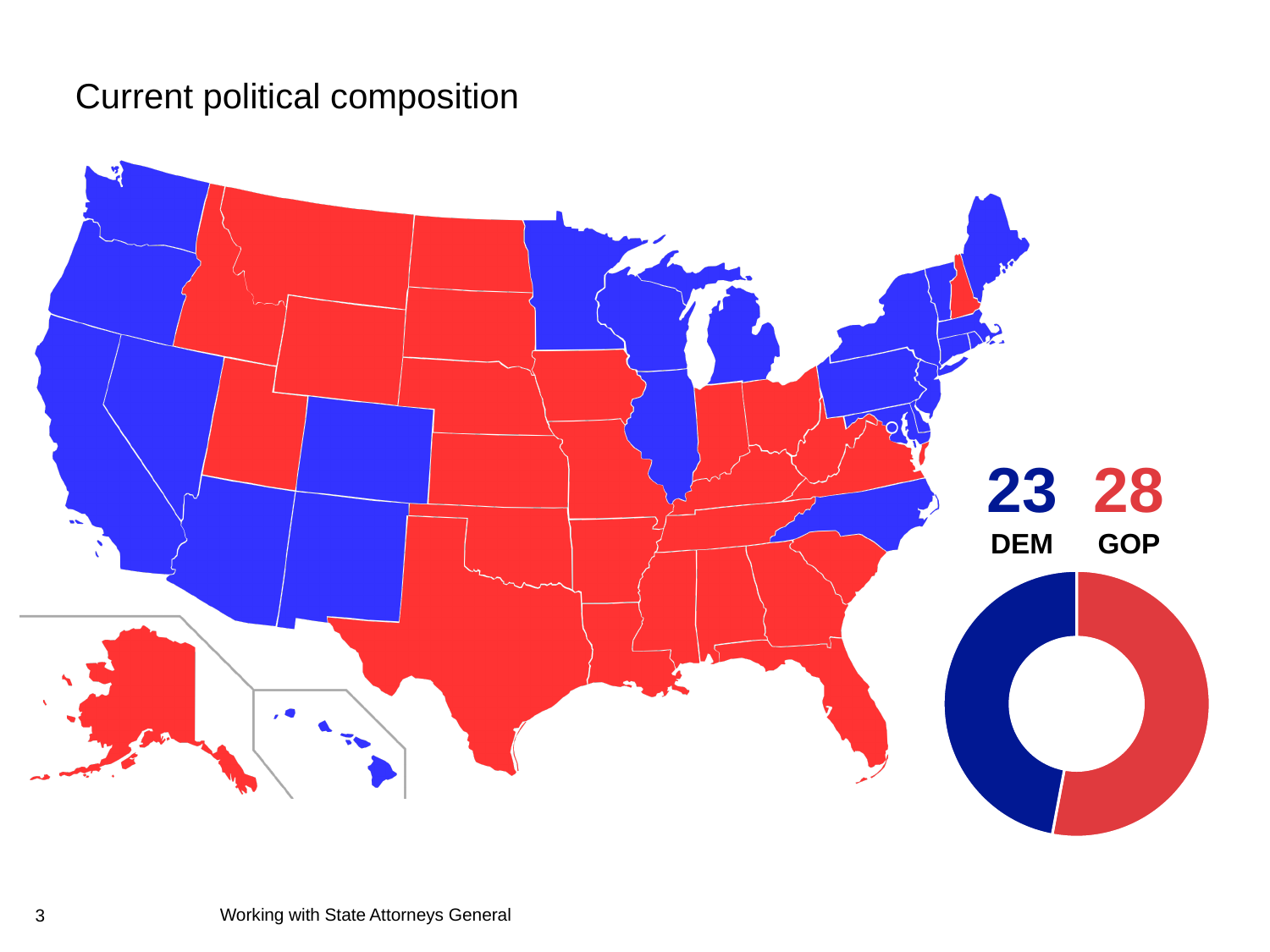
In the donut chart, which category has the larger value? GOP How many categories does the donut chart show? 2 In the donut chart, is the DEM value larger or smaller than the GOP value? smaller In the donut chart, which category has the smaller value? DEM In the donut chart, what is the total of the DEM and GOP values? 51 What kind of chart is shown at the bottom right of the slide? donut (pie) chart In the donut chart, what is the value for DEM? 23 What colour represents DEM in the donut chart? dark blue What is the title of the slide containing the donut chart? Current political composition In the donut chart, what is the difference between the GOP value and the DEM value? 5 In the donut chart, what is the value for GOP? 28